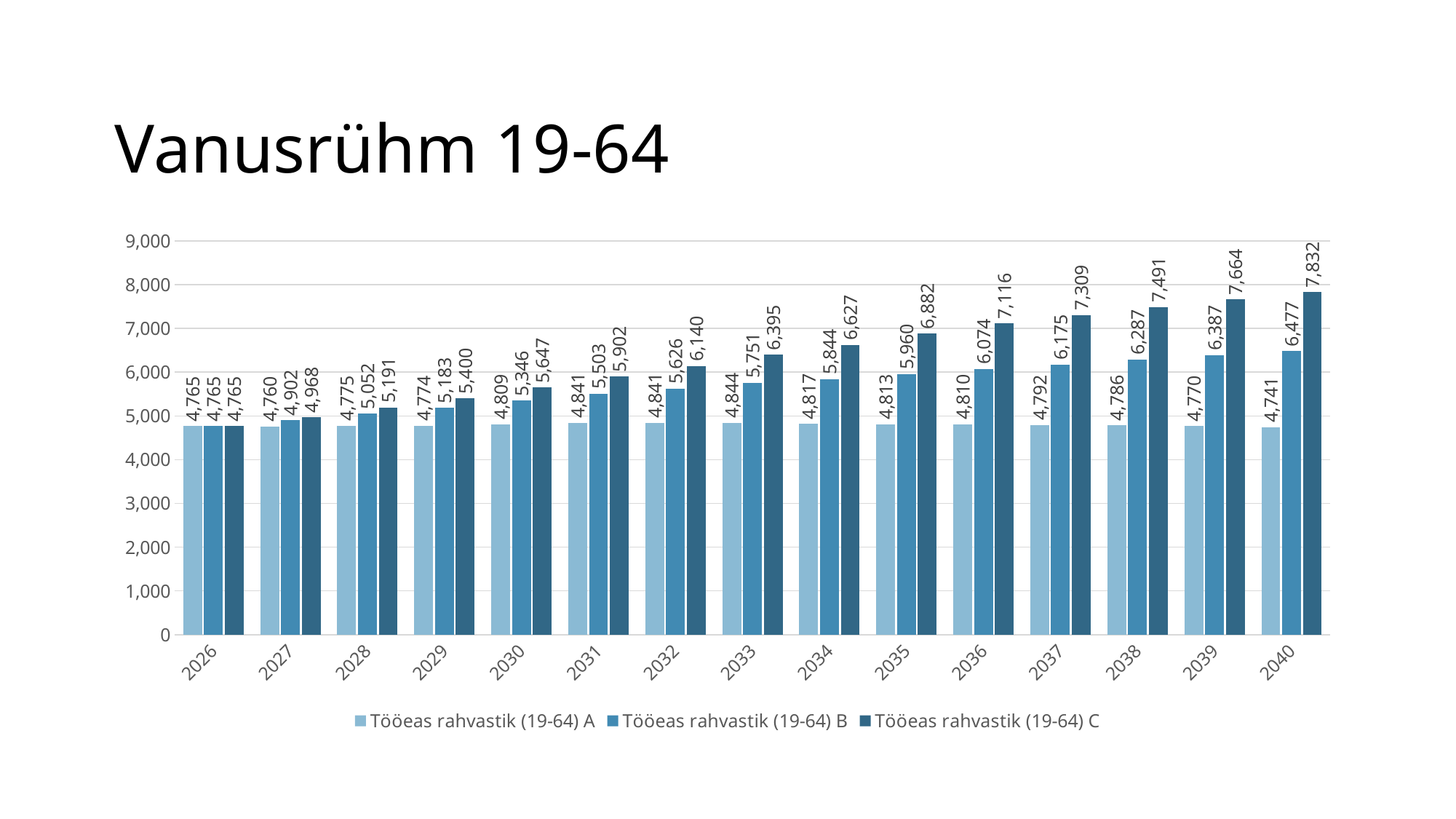
In which year is the value for Tööeas rahvastik (19-64) C highest? 2040 What is the value for Tööeas rahvastik (19-64) A in 2026? 4,765 How many series does the legend list? 3 Which is larger in 2035: Tööeas rahvastik (19-64) B or Tööeas rahvastik (19-64) C? Tööeas rahvastik (19-64) C What is the value for Tööeas rahvastik (19-64) C in 2040? 7,832 How many years are shown on the x axis? 15 What is the value for Tööeas rahvastik (19-64) B in 2033? 5,751 What is the difference between Tööeas rahvastik (19-64) C and Tööeas rahvastik (19-64) A in 2040? 3,091 Does the value for Tööeas rahvastik (19-64) C rise or fall from 2026 to 2040? Rise What kind of chart is shown on the slide? Bar chart In which year is the value for Tööeas rahvastik (19-64) A lowest? 2040 Is the value for Tööeas rahvastik (19-64) C in 2036 greater or less than 7,000? greater